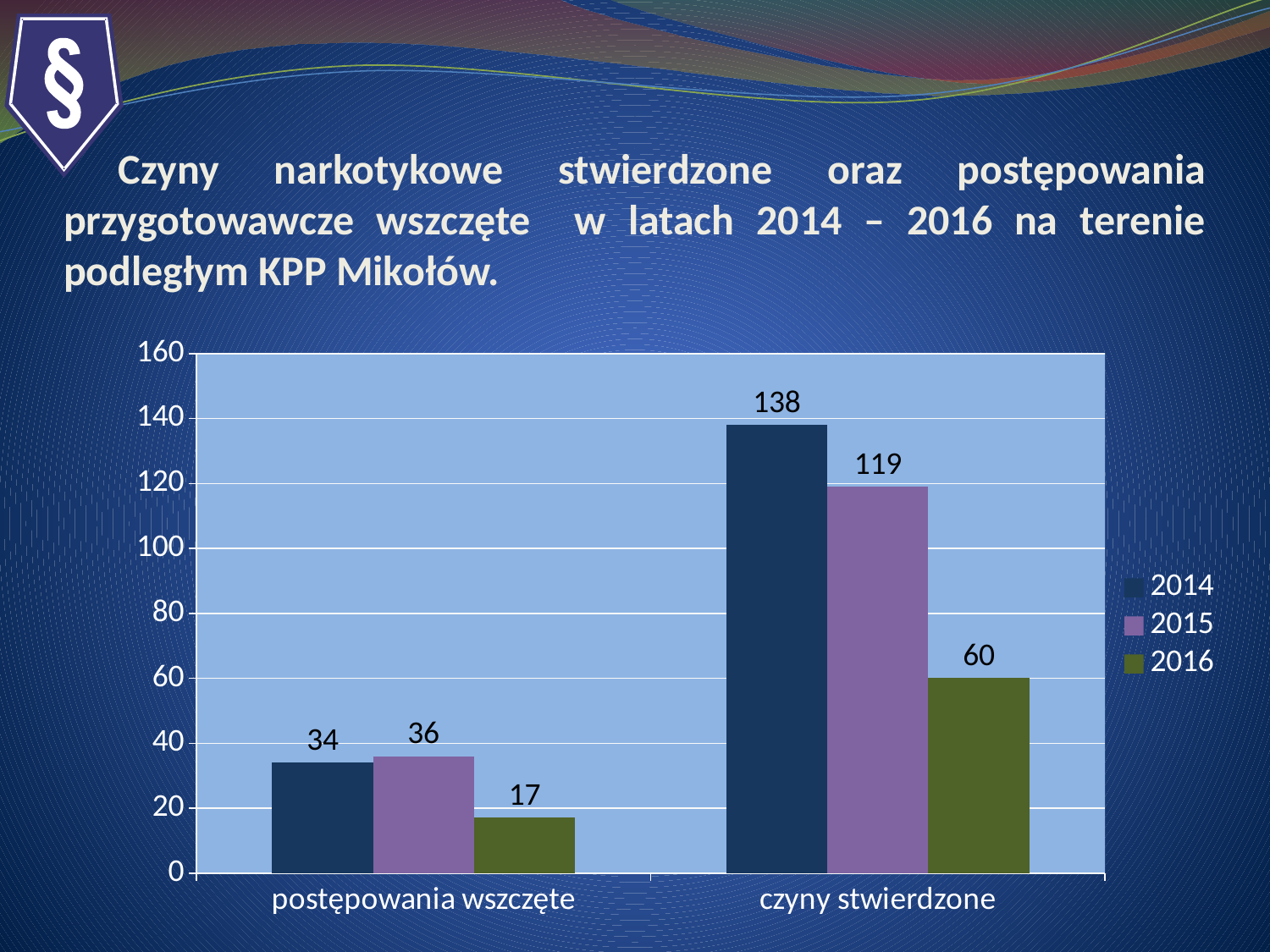
What kind of chart is shown on the slide? bar chart Which is larger: the 2015 value for 'postępowania wszczęte' or the 2016 value for 'postępowania wszczęte'? 2015 Which year has the highest value in the 'czyny stwierdzone' category? 2014 Which year has the lowest value in the 'postępowania wszczęte' category? 2016 How many categories are shown on the x axis? 2 How many series does the legend list? 3 What is the value for 2015 in the 'czyny stwierdzone' category? 119 What is the value for 2016 in the 'postępowania wszczęte' category? 17 What is the value for 2014 in the 'czyny stwierdzone' category? 138 What is the difference between the 2014 and 2016 values for 'czyny stwierdzone'? 78 What is the difference between the 2015 and 2014 values for 'postępowania wszczęte'? 2 Which series is shown in green in the legend? 2016